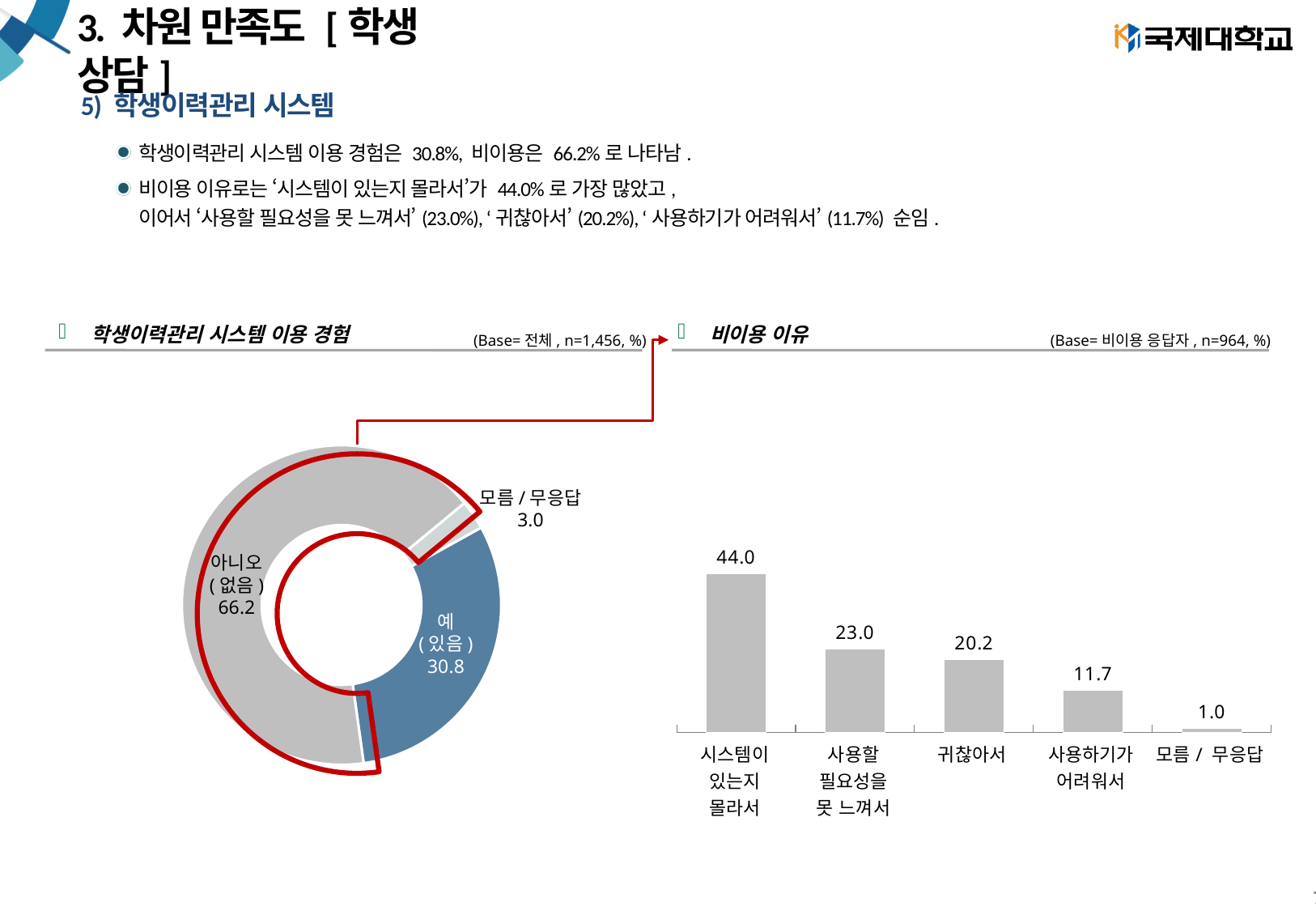
In the '비이용 이유' bar chart, what is the value for '귀찮아서'? 20.2 In the '비이용 이유' bar chart, how many categories are shown? 5 In the '학생이력관리 시스템 이용 경험' donut chart, what is the value for '예 (있음)'? 30.8 In the '비이용 이유' bar chart, what is the value for '시스템이 있는지 몰라서'? 44.0 In the '비이용 이유' bar chart, which category has the lowest value? 모름 / 무응답 What kind of chart is the '비이용 이유' chart on the right? bar chart In the '비이용 이유' bar chart, which category has the highest value? 시스템이 있는지 몰라서 In the '비이용 이유' bar chart, what is the value for '사용하기가 어려워서'? 11.7 In the '비이용 이유' bar chart, do the values rise or fall from left to right? fall In the '비이용 이유' bar chart, what is the difference between '시스템이 있는지 몰라서' and '사용할 필요성을 못 느껴서'? 21.0 In the '학생이력관리 시스템 이용 경험' donut chart, what is the value for '모름 / 무응답'? 3.0 In the '학생이력관리 시스템 이용 경험' donut chart, which is larger, '아니오 (없음)' or '예 (있음)'? 아니오 (없음)